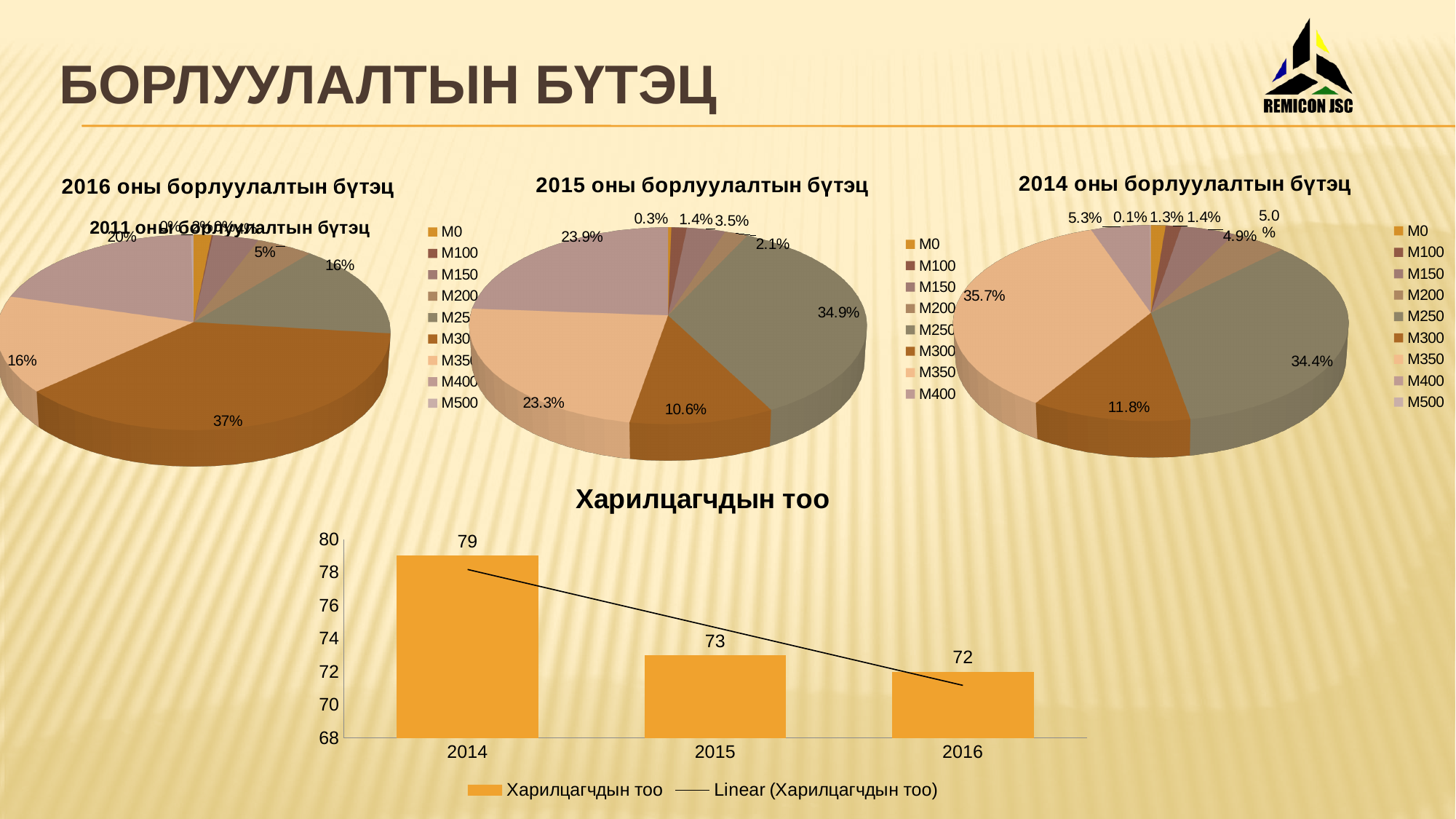
In the 'Харилцагчдын тоо' bar chart, what is the value for 2016? 72 How many entries does the legend of the 'Харилцагчдын тоо' chart list? 2 In the '2014 оны борлуулалтын бүтэц' pie chart, what is the largest labelled share? 35.7% In the 'Харилцагчдын тоо' bar chart, what is the value for 2014? 79 In the '2016 оны борлуулалтын бүтэц' pie chart, what is the largest labelled share? 37% In the 'Харилцагчдын тоо' bar chart, do the values rise or fall from 2014 to 2016? fall In the 'Харилцагчдын тоо' bar chart, how many years are shown on the x axis? 3 What kind of chart is the 'Харилцагчдын тоо' chart at the bottom of the slide? bar chart In the 'Харилцагчдын тоо' bar chart, which year has the lowest value? 2016 In the 'Харилцагчдын тоо' bar chart, which year has the highest value? 2014 In the 'Харилцагчдын тоо' bar chart, what is the difference between the 2014 and 2015 values? 6